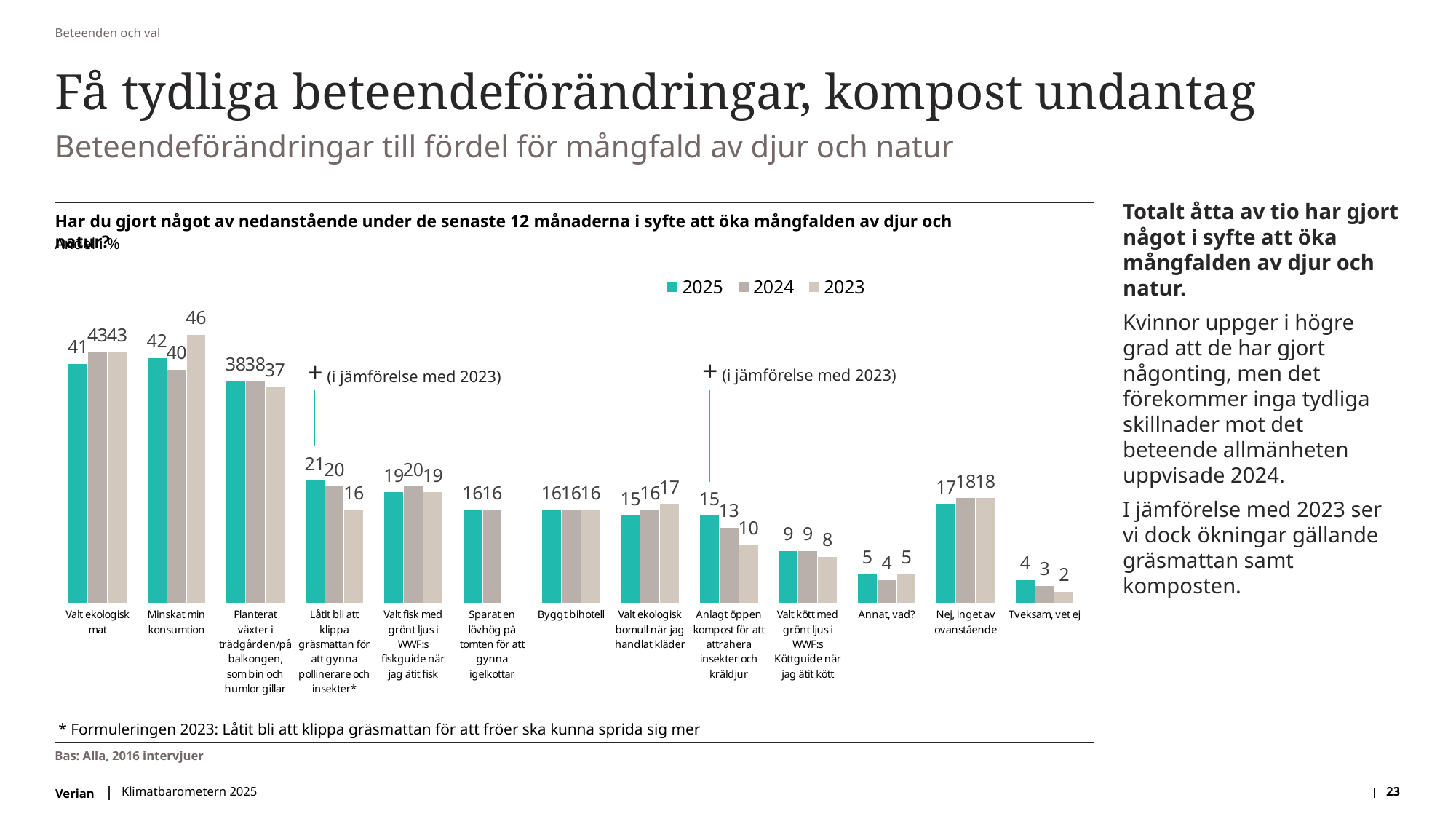
Which category has the highest 2025 value? Minskat min konsumtion Which is larger for "Valt ekologisk mat": the 2025 value or the 2023 value? 2023 What is the 2024 value for "Låtit bli att klippa gräsmattan för att gynna pollinerare och insekter*"? 20 Which series is shown in teal in the legend? 2025 What is the difference between the 2025 and 2023 values for "Anlagt öppen kompost för att attrahera insekter och kräldjur"? 5 What is the 2023 value for "Minskat min konsumtion"? 46 How many categories are shown on the x axis? 13 What kind of chart is shown on the slide? Bar chart Which category has the lowest 2023 value? Tveksam, vet ej How many series does the legend list? 3 What is the 2025 value for "Anlagt öppen kompost för att attrahera insekter och kräldjur"? 15 What is the 2025 value for "Nej, inget av ovanstående"? 17